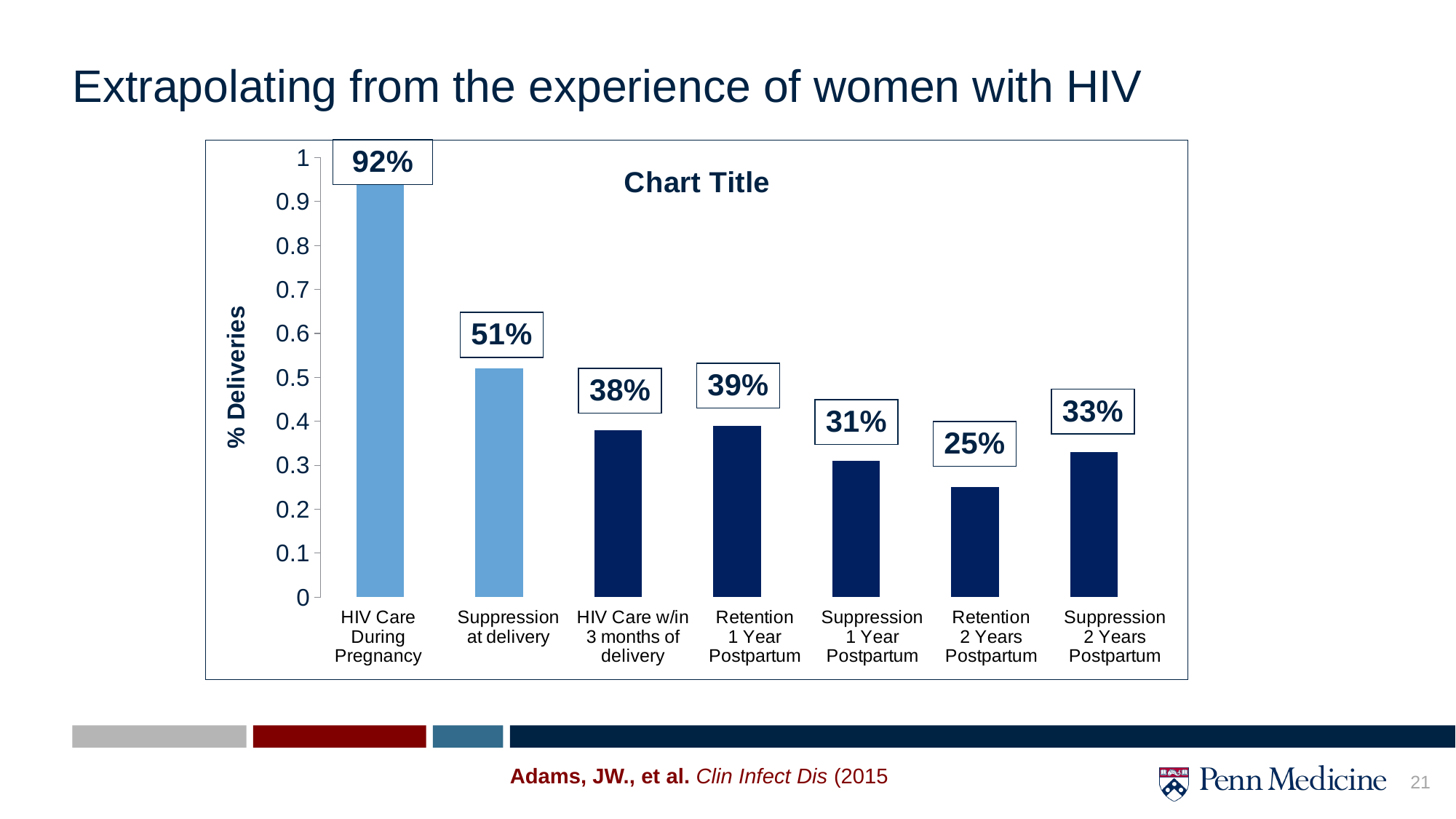
What kind of chart is shown on the slide? Bar chart How many categories are shown on the x axis? 7 Which category has the highest value? HIV Care During Pregnancy What is the label on the vertical axis? % Deliveries What is the value for Suppression 1 Year Postpartum? 31% What is the value for Suppression at delivery? 51% Which category has the lowest value? Retention 2 Years Postpartum Which is larger, Retention 1 Year Postpartum or Suppression 1 Year Postpartum? Retention 1 Year Postpartum What is the value for HIV Care During Pregnancy? 92% What is the difference between Suppression 2 Years Postpartum and Retention 2 Years Postpartum? 8% What is the value for Retention 2 Years Postpartum? 25% What is the difference between HIV Care During Pregnancy and Suppression at delivery? 41%